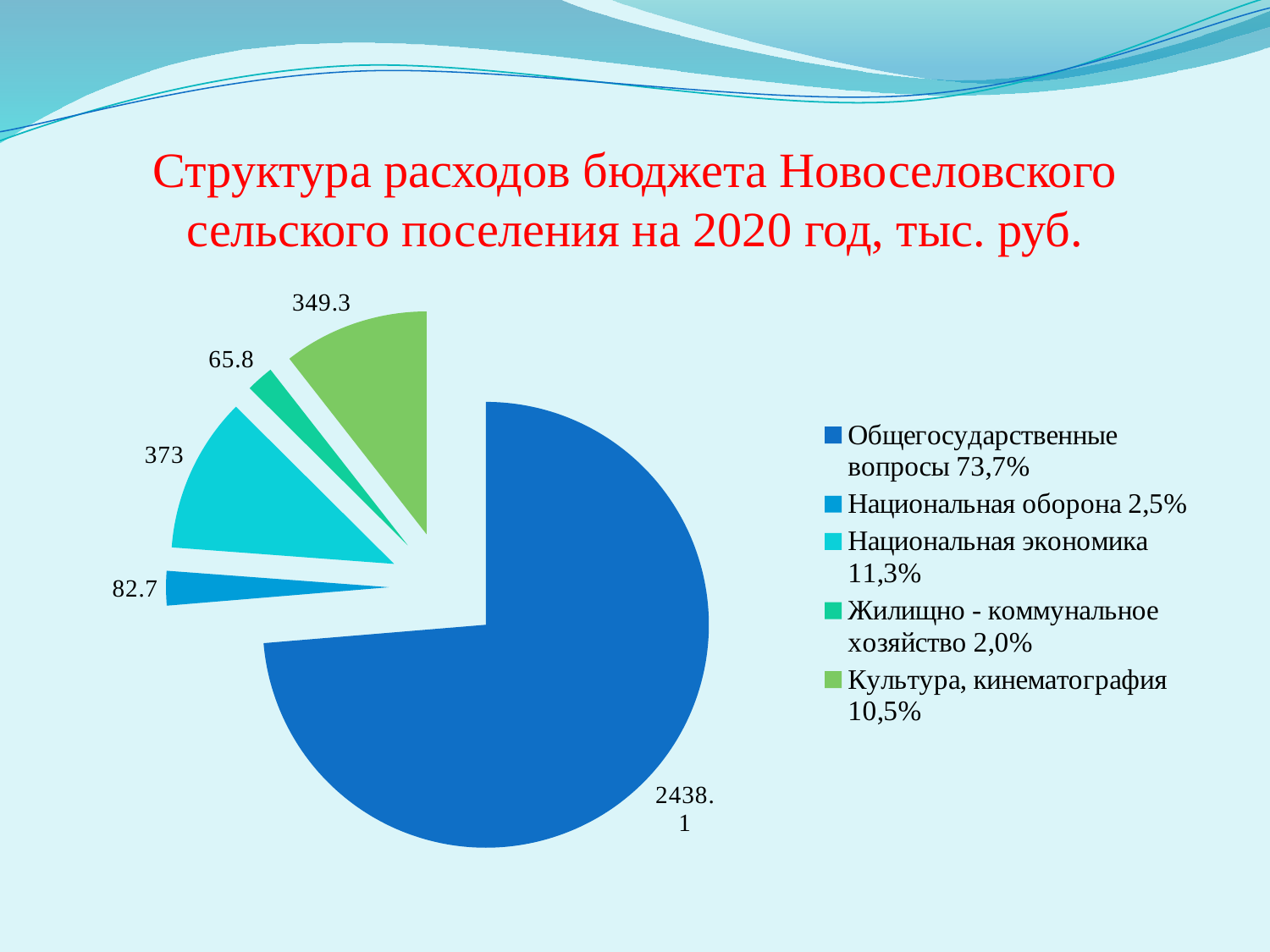
What share of the pie does Национальная экономика represent, according to the legend? 11,3% What is the value for Общегосударственные вопросы? 2438.1 What kind of chart is shown on the slide? pie chart What is the difference between the values for Национальная экономика and Культура, кинематография? 23.7 What is the value for Культура, кинематография? 349.3 What is the value for Национальная оборона? 82.7 Which is larger: the value for Национальная оборона or the value for Жилищно - коммунальное хозяйство? Национальная оборона How many categories does the pie chart show? 5 Which category has the smallest slice of the pie? Жилищно - коммунальное хозяйство Which category has the largest slice of the pie? Общегосударственные вопросы What is the value for Национальная экономика? 373 What share of the pie does Культура, кинематография represent, according to the legend? 10,5%